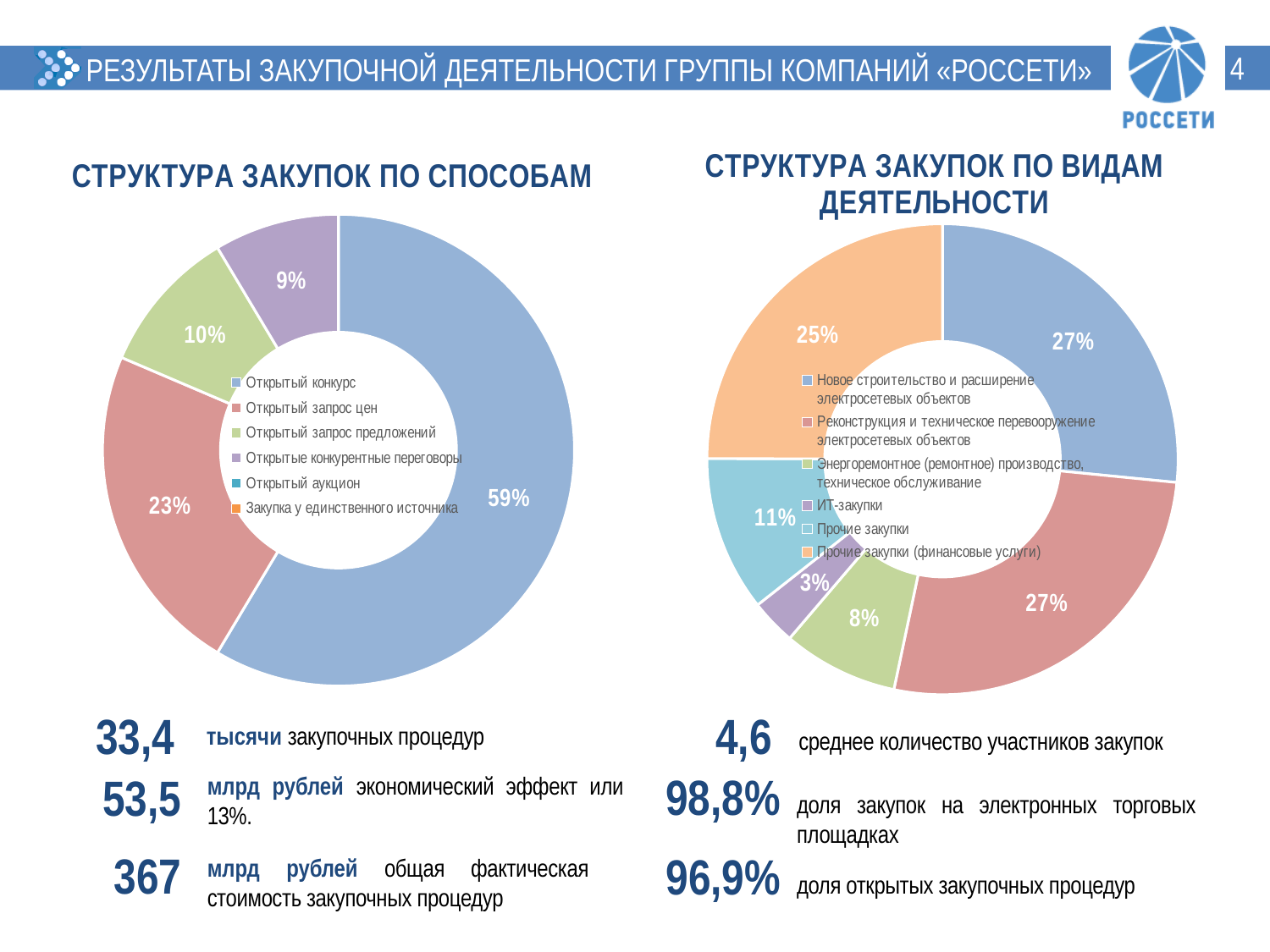
In the chart titled «СТРУКТУРА ЗАКУПОК ПО ВИДАМ ДЕЯТЕЛЬНОСТИ», what share is shown for «Прочие закупки (финансовые услуги)»? 25% In the chart titled «СТРУКТУРА ЗАКУПОК ПО СПОСОБАМ», what share is shown for «Открытый запрос цен»? 23% In the chart titled «СТРУКТУРА ЗАКУПОК ПО СПОСОБАМ», which category has the largest share? Открытый конкурс What type of chart is «СТРУКТУРА ЗАКУПОК ПО ВИДАМ ДЕЯТЕЛЬНОСТИ»? Pie (doughnut) chart In the chart titled «СТРУКТУРА ЗАКУПОК ПО СПОСОБАМ», what is the difference in percentage points between «Открытый конкурс» and «Открытый запрос цен»? 36 percentage points In the chart titled «СТРУКТУРА ЗАКУПОК ПО ВИДАМ ДЕЯТЕЛЬНОСТИ», which is larger: «Прочие закупки» or «Энергоремонтное (ремонтное) производство, техническое обслуживание»? Прочие закупки How many entries does the legend of the chart titled «СТРУКТУРА ЗАКУПОК ПО СПОСОБАМ» list? 6 In the chart titled «СТРУКТУРА ЗАКУПОК ПО ВИДАМ ДЕЯТЕЛЬНОСТИ», what is the difference in percentage points between «Прочие закупки (финансовые услуги)» and «Прочие закупки»? 14 percentage points In the chart titled «СТРУКТУРА ЗАКУПОК ПО ВИДАМ ДЕЯТЕЛЬНОСТИ», what share is shown for «ИТ-закупки»? 3% In the chart titled «СТРУКТУРА ЗАКУПОК ПО СПОСОБАМ», which is larger: «Открытый запрос предложений» or «Открытые конкурентные переговоры»? Открытый запрос предложений In the chart titled «СТРУКТУРА ЗАКУПОК ПО СПОСОБАМ», what share is shown for «Открытый конкурс»? 59% In the chart titled «СТРУКТУРА ЗАКУПОК ПО ВИДАМ ДЕЯТЕЛЬНОСТИ», which category has the smallest share? ИТ-закупки